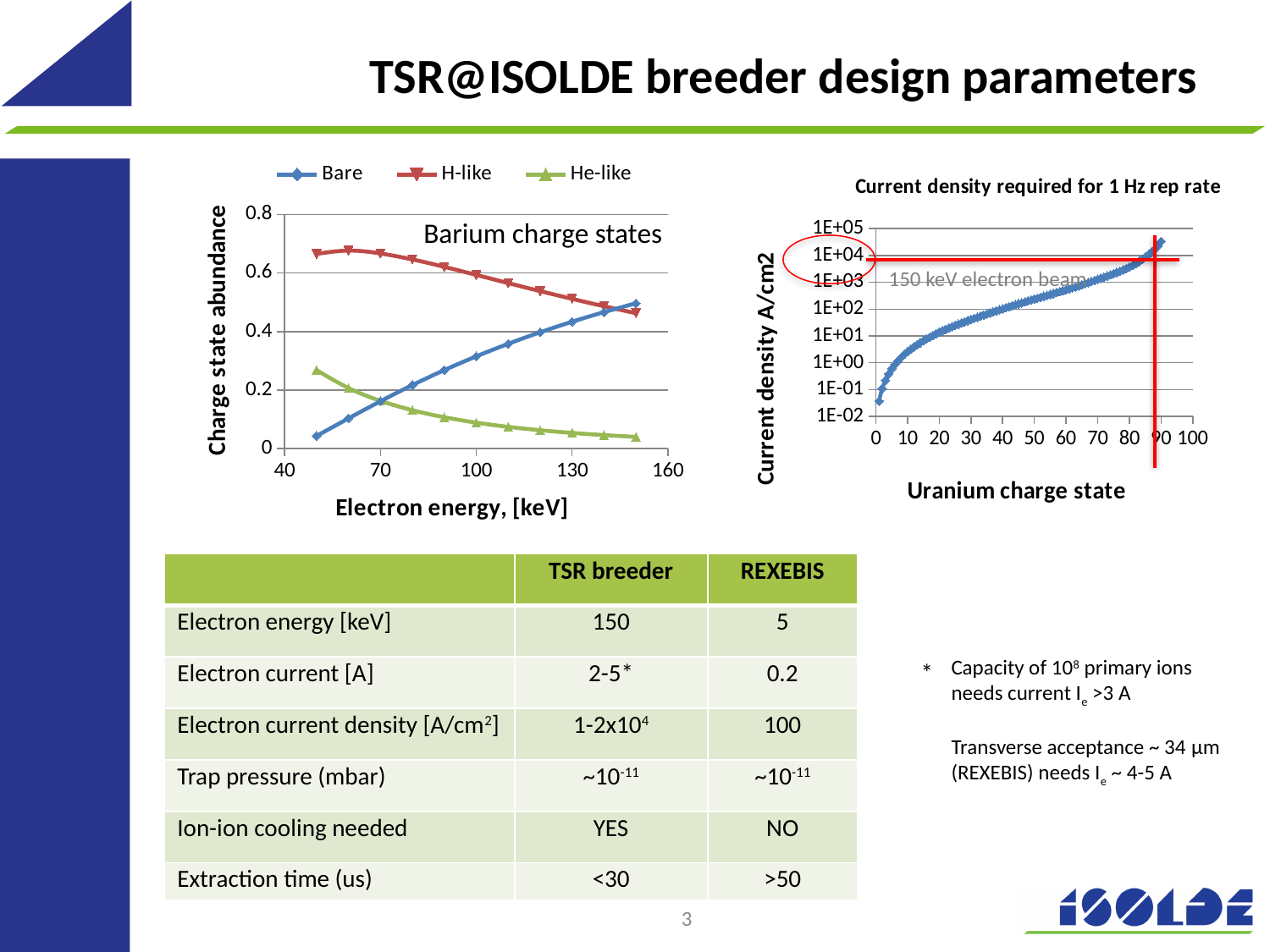
What kind of chart is the Barium charge states chart on the left? line chart In the Barium charge states chart, is the He-like abundance at 150 keV greater or less than 0.2? less In the Barium charge states chart, which series has the highest abundance at 50 keV? H-like In the Barium charge states chart, does the Bare series rise or fall as electron energy increases? rise What is the x-axis label of the chart titled 'Current density required for 1 Hz rep rate'? Uranium charge state In the Barium charge states chart, does the He-like series rise or fall as electron energy increases? fall In the Barium charge states chart, which series has the lowest abundance at 50 keV? Bare In the Barium charge states chart, at 100 keV is the H-like abundance larger or smaller than the Bare abundance? larger In the Barium charge states chart, how many data points does the Bare series have? 11 How many series does the legend of the Barium charge states chart list? 3 In the Barium charge states chart, is the Bare abundance at 150 keV greater or less than 0.4? greater In the chart titled 'Current density required for 1 Hz rep rate', does the current density rise or fall as the uranium charge state increases? rise